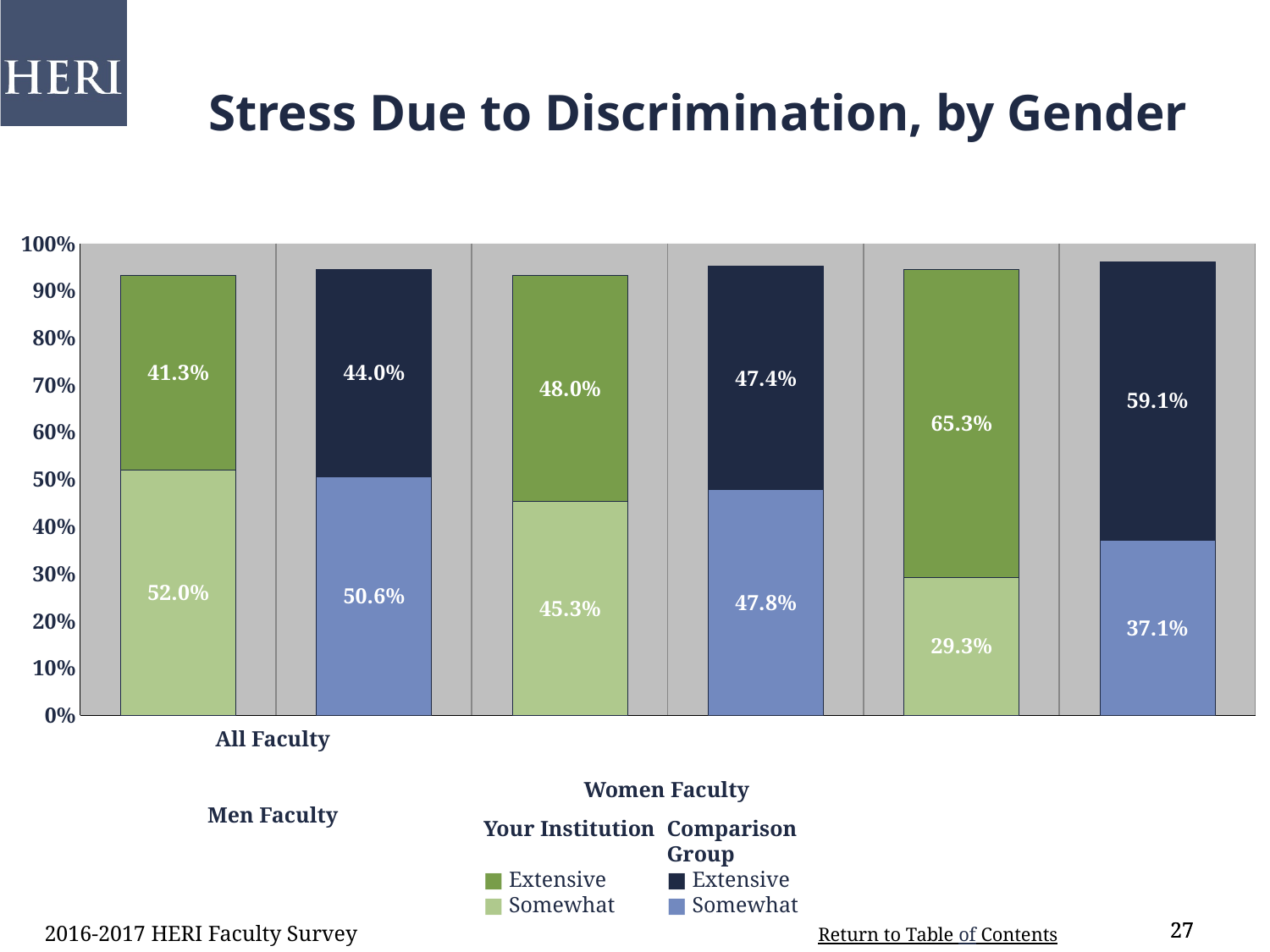
What is the Extensive value for the Comparison Group among Men Faculty? 47.4% Which faculty group has the highest Extensive value for Your Institution? Women Faculty Among All Faculty, which is larger: the Somewhat value for Your Institution or for the Comparison Group? Your Institution What kind of chart is shown on the slide? Stacked bar chart What is the Somewhat value for Your Institution among Men Faculty? 45.3% How many entries does the legend list? 4 What is the total of the Your Institution stacked bar for Women Faculty? 94.6% What is the difference between the Extensive values for Your Institution and the Comparison Group among Women Faculty? 6.2% What is the Extensive value for Your Institution among Women Faculty? 65.3% Which faculty group has the lowest Somewhat value for the Comparison Group? Women Faculty How many faculty groups are shown along the x axis? 3 What is the Somewhat value for the Comparison Group among All Faculty? 50.6%